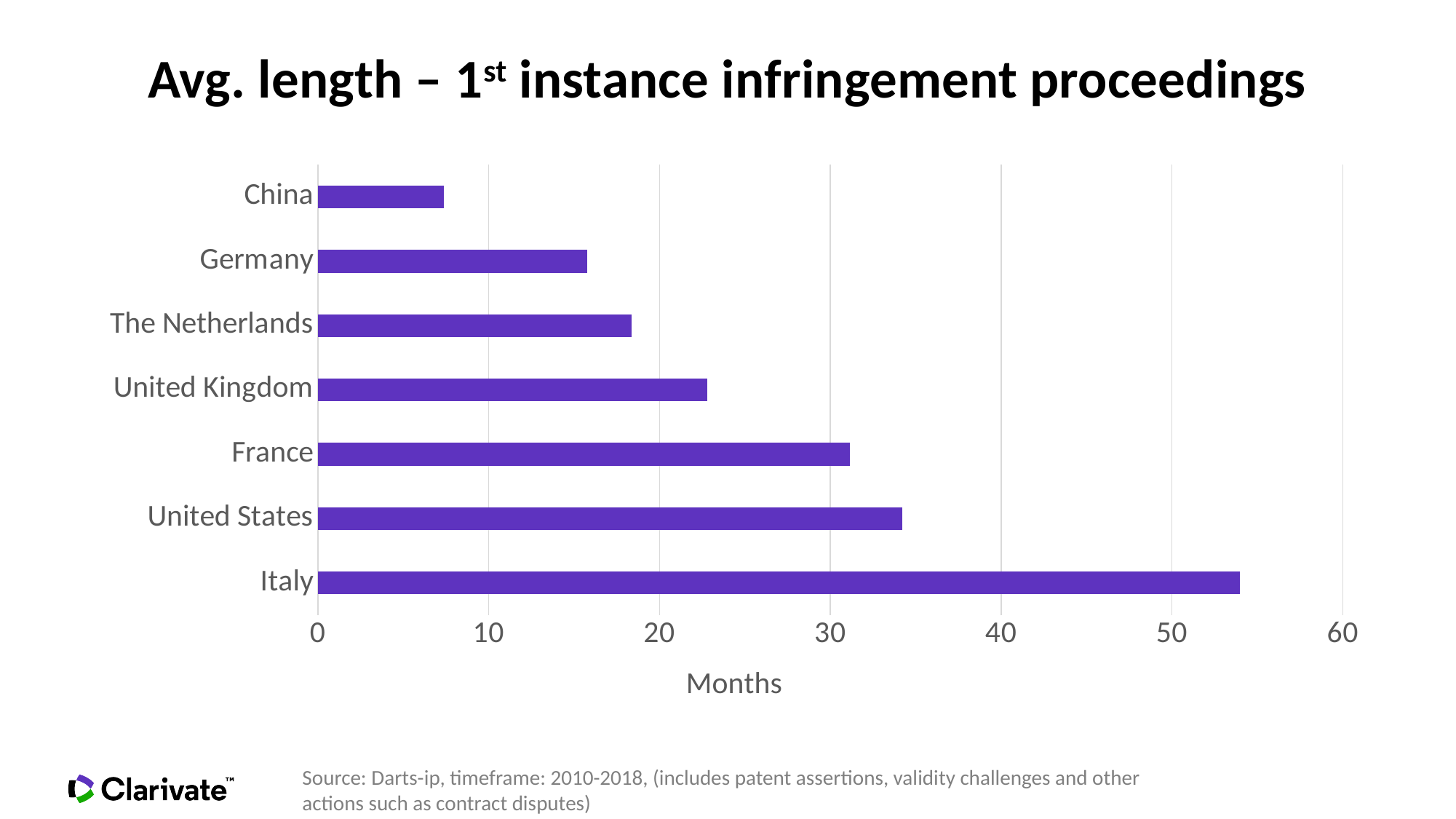
What kind of chart is shown on the slide? bar chart Is the value for United Kingdom greater or less than 20 months? greater Is the value for China greater or less than 10 months? less Which has a longer average proceeding length, the United States or France? United States Which has a longer average proceeding length, Germany or The Netherlands? The Netherlands Is the value for Italy greater or less than 50 months? greater How many countries are shown in the chart? 7 Which country has the shortest average length of 1st instance infringement proceedings? China Which country has the longest average length of 1st instance infringement proceedings? Italy What unit is shown on the horizontal axis of the chart? Months